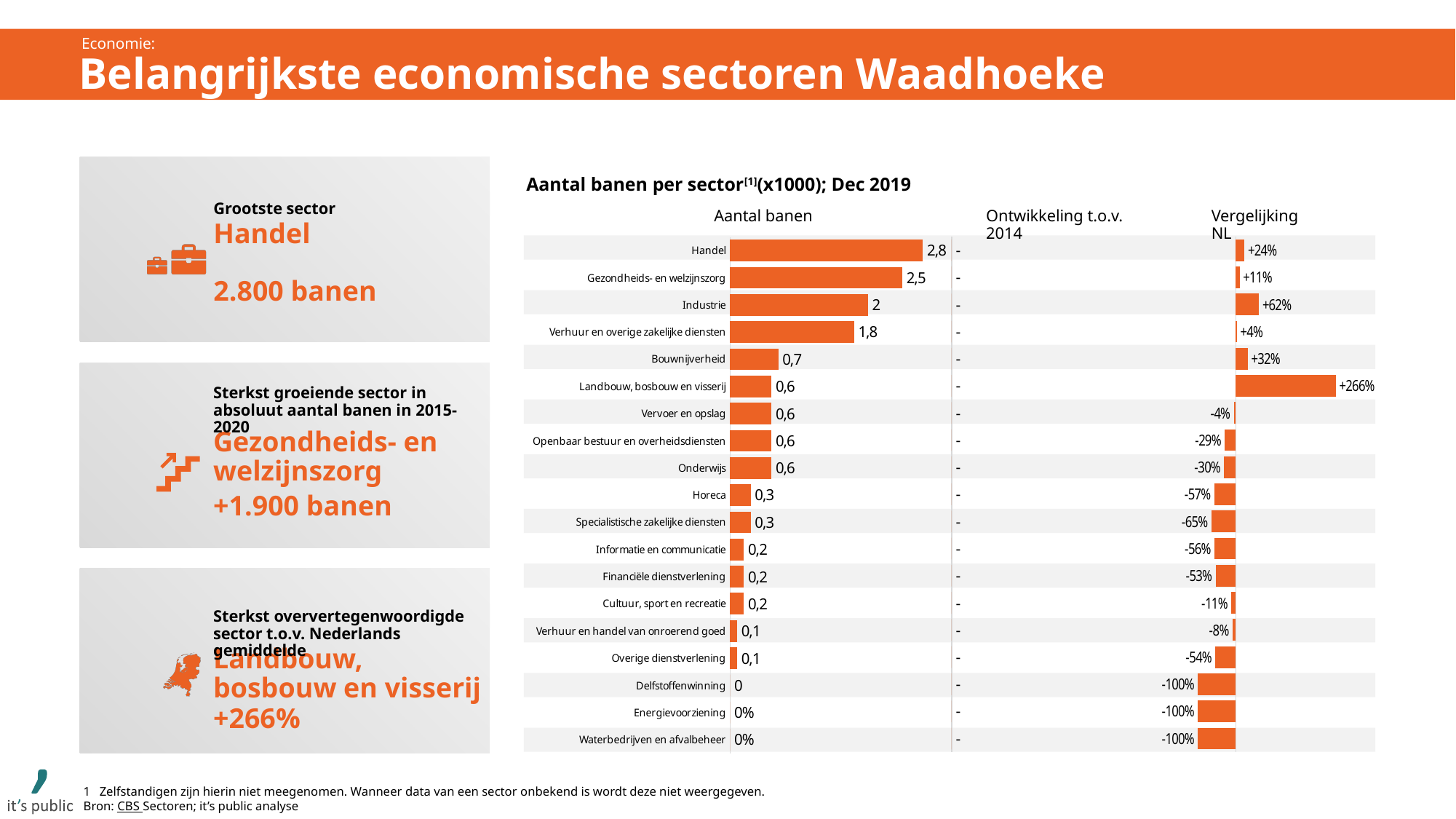
In the 'Aantal banen' chart, what is the value for Handel? 2,8 What kind of chart is the 'Aantal banen' chart? Bar chart In the 'Vergelijking NL' chart, which sector has the highest value? Landbouw, bosbouw en visserij In the 'Vergelijking NL' chart, what is the value for Landbouw, bosbouw en visserij? +266% In the 'Vergelijking NL' chart, which is larger: Industrie or Bouwnijverheid? Industrie How many sectors are listed in the 'Aantal banen' chart? 19 In the 'Aantal banen' chart, which sector has the highest value? Handel In the 'Aantal banen' chart, what is the value for Industrie? 2 In the 'Vergelijking NL' chart, what is the value for Horeca? -57% In the 'Aantal banen' chart, what is the value for Bouwnijverheid? 0,7 What is the title of the chart on the slide? Aantal banen per sector (x1000); Dec 2019 In the 'Aantal banen' chart, what is the difference between Handel and Gezondheids- en welzijnszorg? 0,3